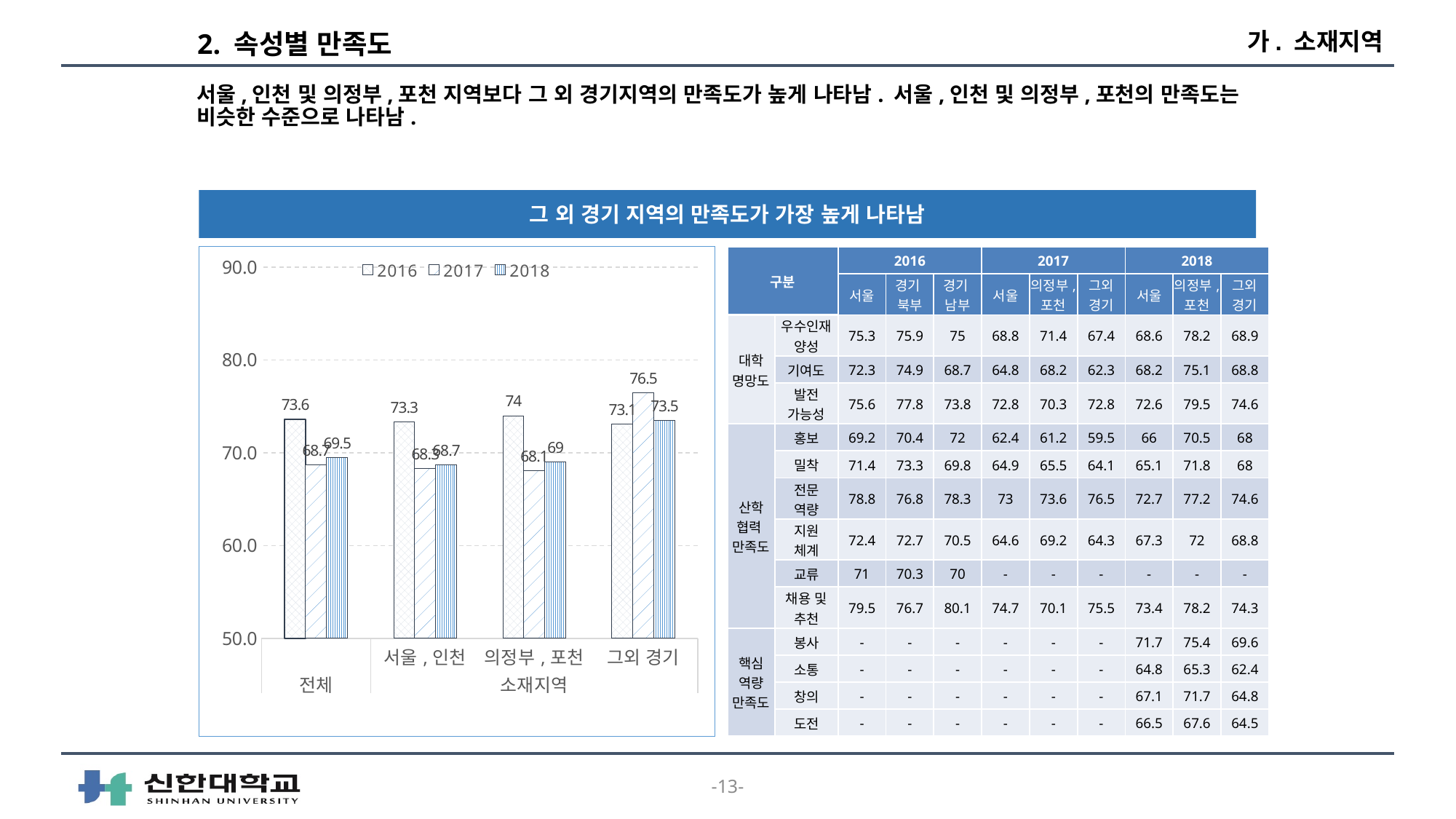
How many categories are shown on the x axis of the chart? 4 Which category has the highest 2017 value in the chart? 그외 경기 What is the 2017 value for 그외 경기 in the chart? 76.5 What is the 2017 value for 서울 , 인천 in the chart? 68.3 What type of chart is shown on the slide? bar chart What is the title shown in the blue banner above the chart? 그 외 경기 지역의 만족도가 가장 높게 나타남 What is the 2018 value for 의정부 , 포천 in the chart? 69 What is the 2016 value for 전체 in the chart? 73.6 How many series does the chart legend list? 3 What is the difference between the 2017 values for 그외 경기 and 서울 , 인천? 8.2 Which is larger, the 2016 value for 의정부 , 포천 or the 2016 value for 그외 경기? 의정부 , 포천 Which category has the lowest 2017 value in the chart? 의정부 , 포천